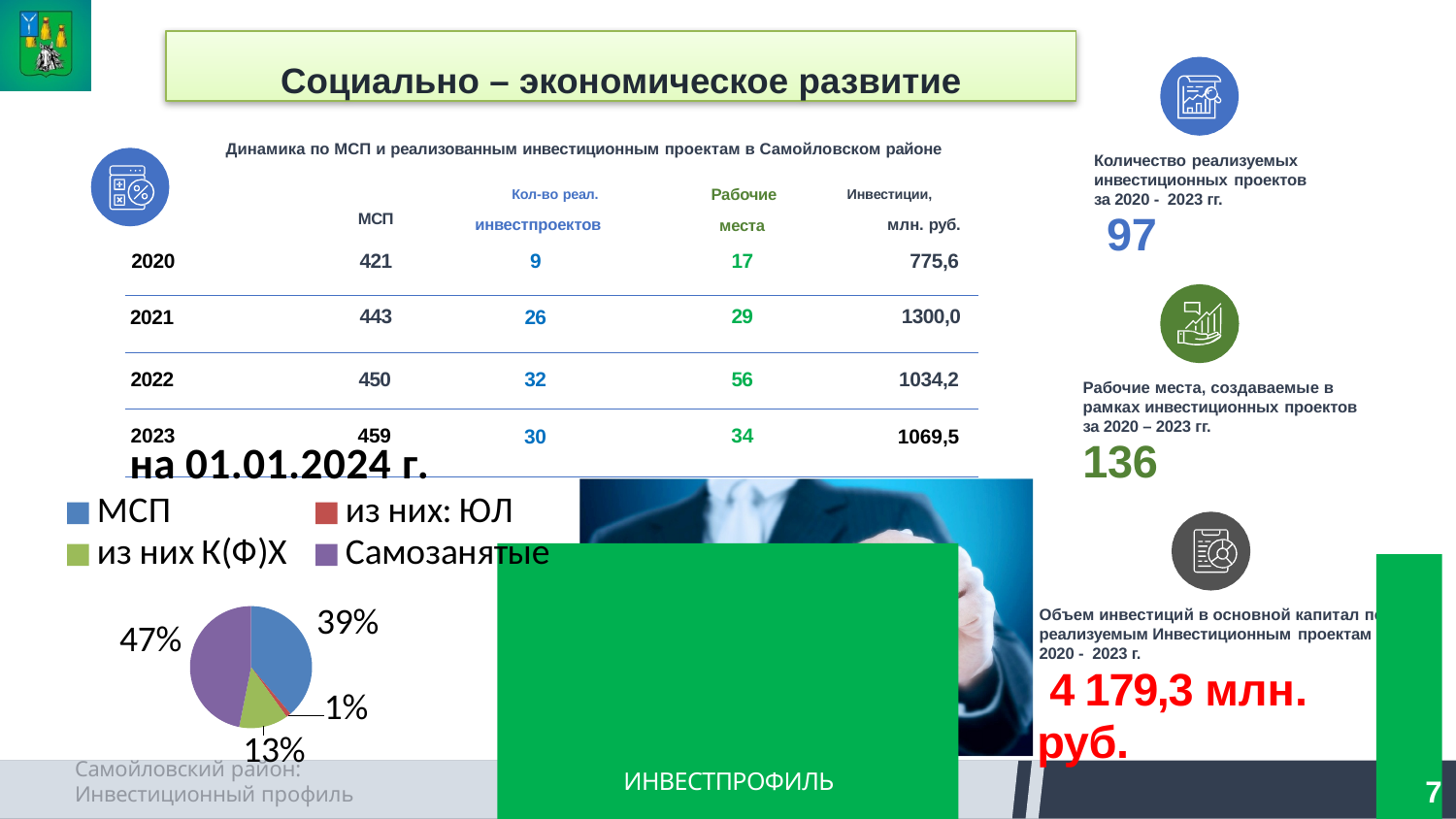
In the pie chart, what share is labelled for из них К(Ф)Х? 13% In the pie chart, what share is labelled for Самозанятые? 47% Which category has the smallest slice in the pie chart? из них: ЮЛ In the pie chart, what is the difference between the share for Самозанятые and the share for МСП? 8% In the pie chart, what share is labelled for МСП? 39% In the pie chart, which is larger: the share for МСП or the share for из них К(Ф)Х? МСП What is the title shown above the pie chart? на 01.01.2024 г. How many slices does the pie chart have? 4 In the pie chart, what share is labelled for из них: ЮЛ? 1% What kind of chart is shown at the bottom left of the slide? pie chart Which category has the largest slice in the pie chart? Самозанятые How many entries does the pie chart legend list? 4